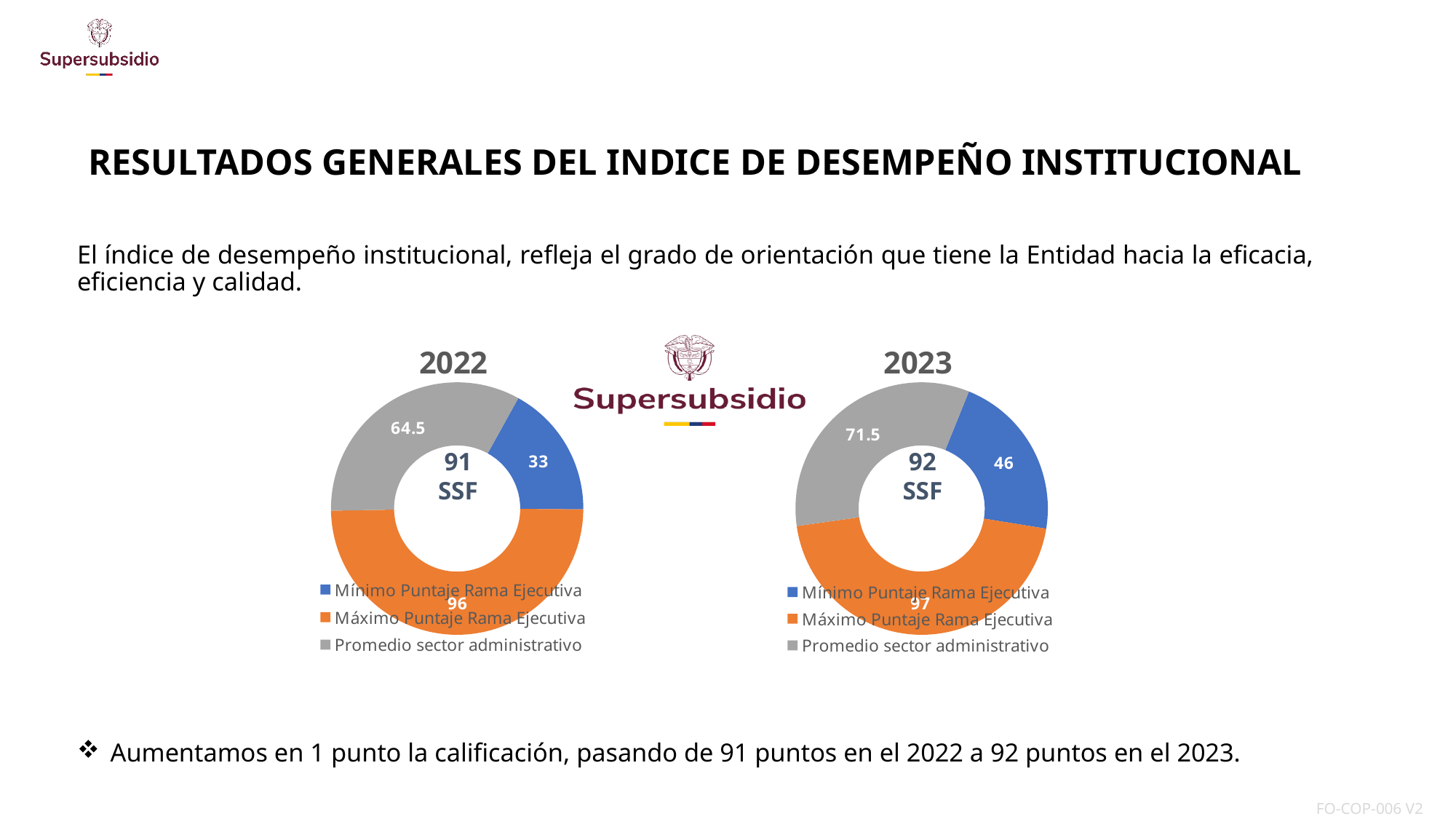
In the 2022 chart, what is the value for Mínimo Puntaje Rama Ejecutiva? 33 In the 2022 chart, which category has the lowest value? Mínimo Puntaje Rama Ejecutiva In the 2022 chart, what is the value for Máximo Puntaje Rama Ejecutiva? 96 How many categories does the 2023 chart's legend list? 3 What kind of chart is the 2022 chart? Doughnut chart In the 2022 chart, what is the value for Promedio sector administrativo? 64.5 In the 2023 chart, what is the value for Promedio sector administrativo? 71.5 In the 2023 chart, what is the difference between Máximo Puntaje Rama Ejecutiva and Mínimo Puntaje Rama Ejecutiva? 51 In the 2023 chart, which category has the highest value? Máximo Puntaje Rama Ejecutiva Which is larger: Promedio sector administrativo in the 2022 chart or in the 2023 chart? 2023 In the 2023 chart, what is the value for Mínimo Puntaje Rama Ejecutiva? 46 What value is shown in the centre of the 2023 chart? 92 SSF